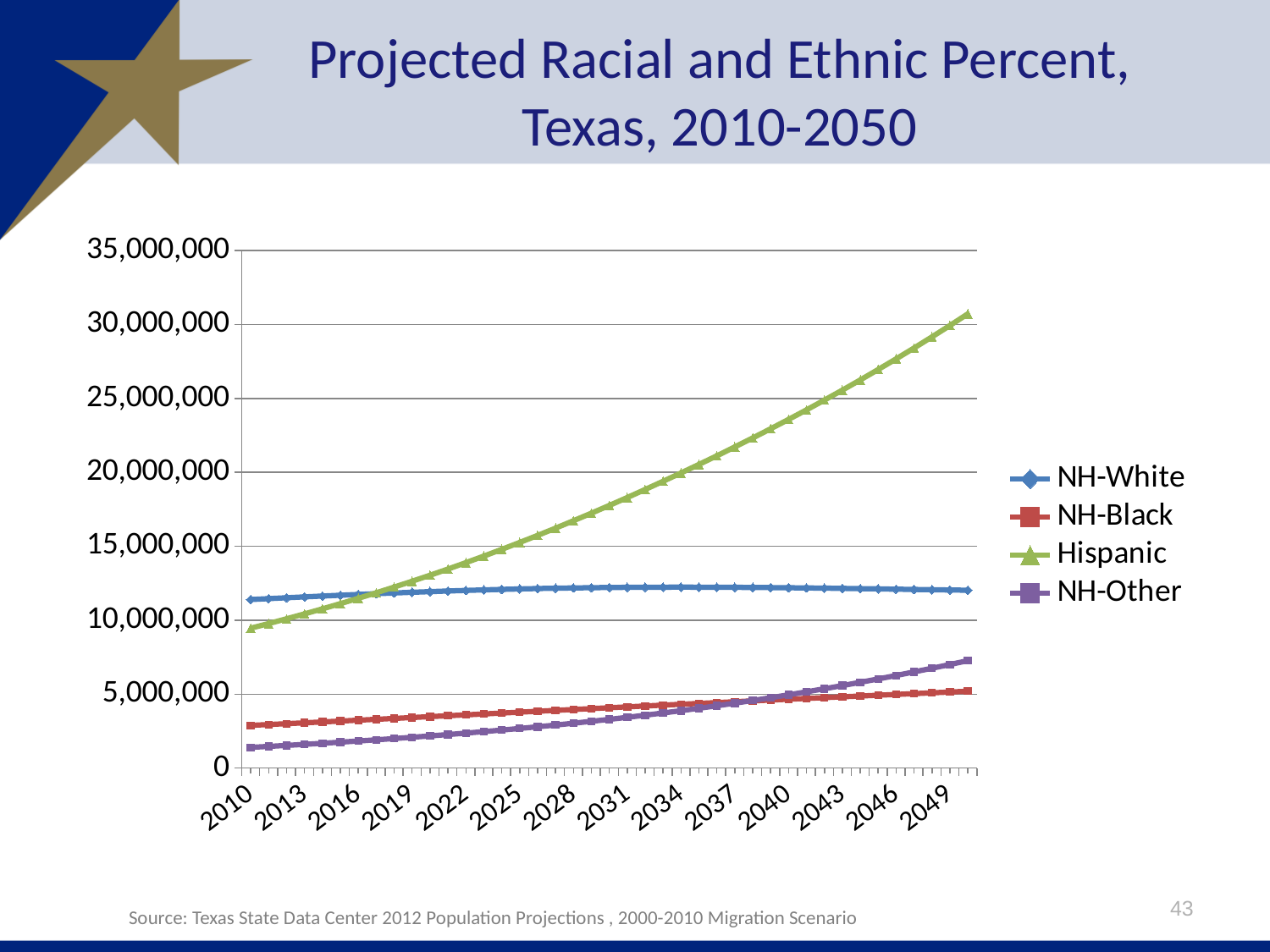
Which series has the lowest value in 2010? NH-Other Which series is plotted with a green line with triangle markers? Hispanic In 2050, which is larger: the Hispanic value or the NH-White value? Hispanic What kind of chart is shown on the slide? line chart Is the NH-White value in 2010 greater or less than 10,000,000? greater Does the NH-Other series rise or fall from 2010 to 2050? rise Which series has the highest value in 2050? Hispanic Does the Hispanic series rise or fall from 2010 to 2050? rise How many series does the legend list? 4 Is the NH-Black value in 2010 greater or less than 5,000,000? less Is the Hispanic value in 2050 greater or less than 25,000,000? greater What is the title of the chart? Projected Racial and Ethnic Percent, Texas, 2010-2050